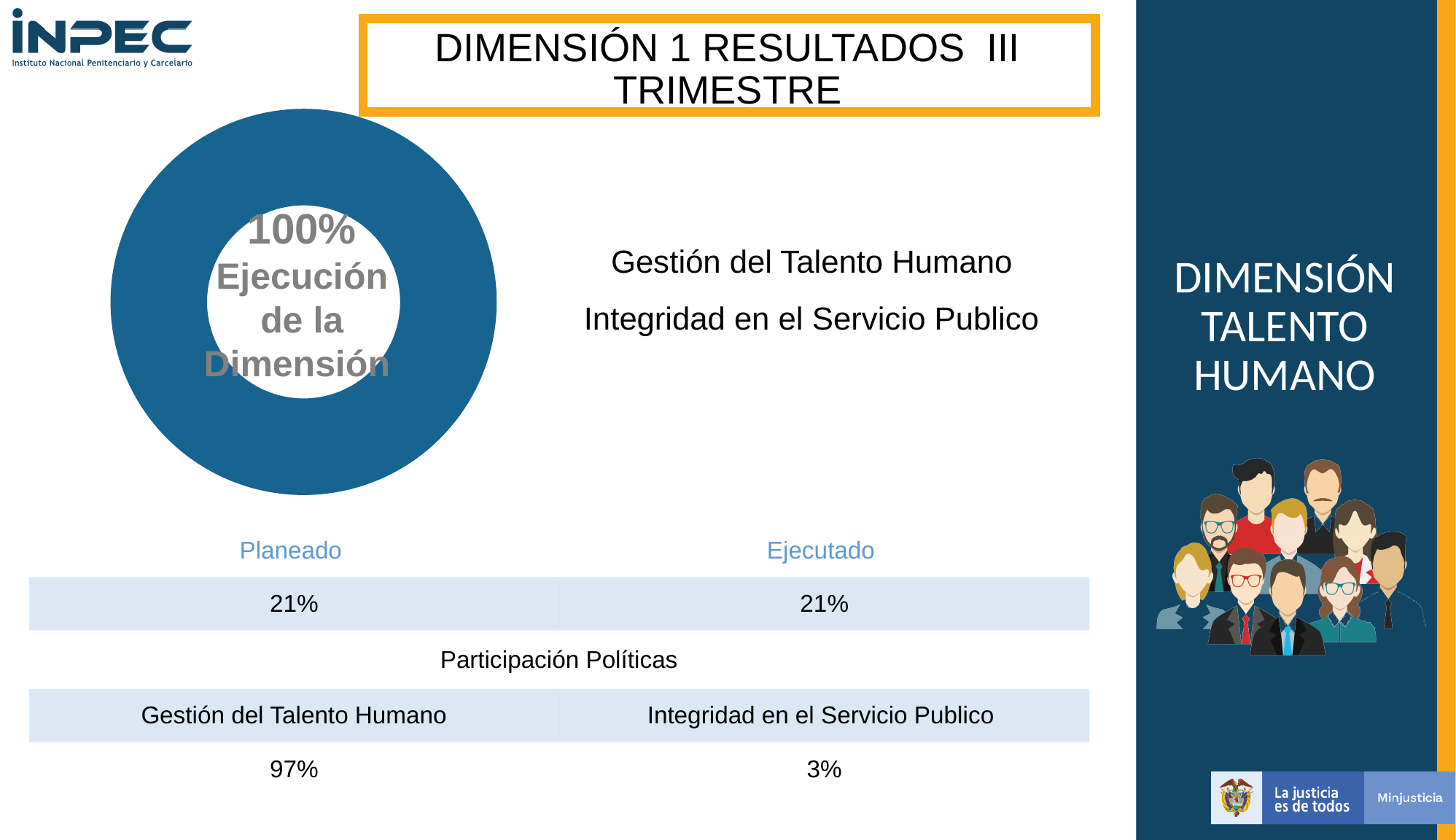
What kind of chart is shown on the left of the slide? doughnut chart What percentage is printed in the centre of the doughnut chart? 100% Is the value shown in the doughnut chart greater or less than 50%? greater What colour is the ring of the doughnut chart? blue What does the text in the centre of the doughnut chart say the 100% represents? Ejecución de la Dimensión What share of the doughnut chart does the single blue slice occupy? 100% How many distinct slices are visible in the doughnut chart? 1